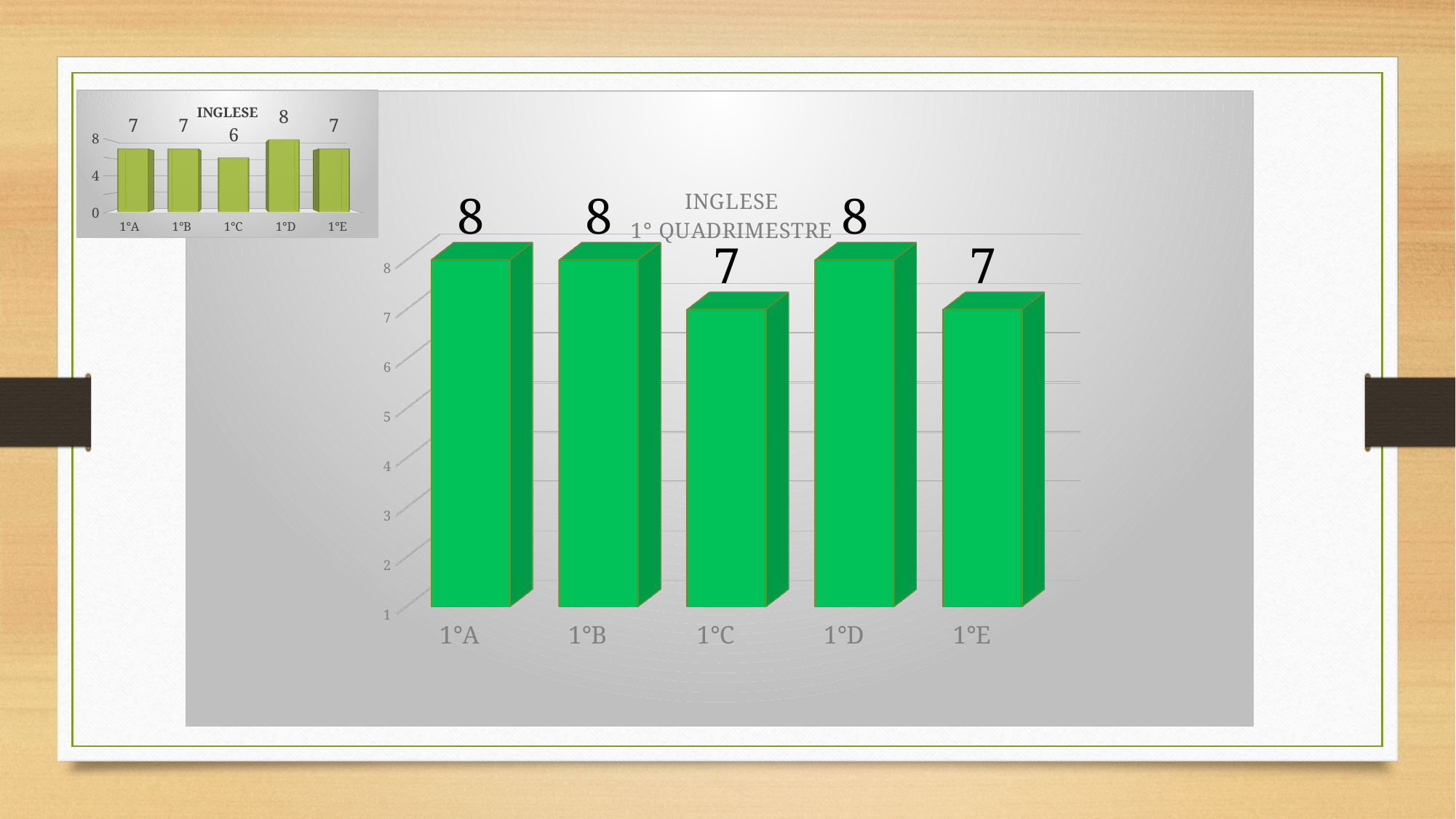
In the small chart titled INGLESE in the top-left corner, which category has the lowest value? 1°C In the small chart titled INGLESE in the top-left corner, which category has the highest value? 1°D What kind of chart is the large chart titled INGLESE 1° QUADRIMESTRE? Bar chart In the small chart titled INGLESE in the top-left corner, what is the value for 1°E? 7 In the small chart titled INGLESE in the top-left corner, what is the value for 1°C? 6 In the small chart titled INGLESE in the top-left corner, what is the difference between the values for 1°D and 1°C? 2 In the large chart titled INGLESE 1° QUADRIMESTRE, how many categories are shown on the x axis? 5 In the large chart titled INGLESE 1° QUADRIMESTRE, what is the value for 1°C? 7 In the large chart titled INGLESE 1° QUADRIMESTRE, which is larger, the value for 1°B or the value for 1°C? 1°B In the large chart titled INGLESE 1° QUADRIMESTRE, what is the value for 1°A? 8 In the large chart titled INGLESE 1° QUADRIMESTRE, what is the difference between the values for 1°D and 1°E? 1 What is the title of the large chart on the slide? INGLESE 1° QUADRIMESTRE